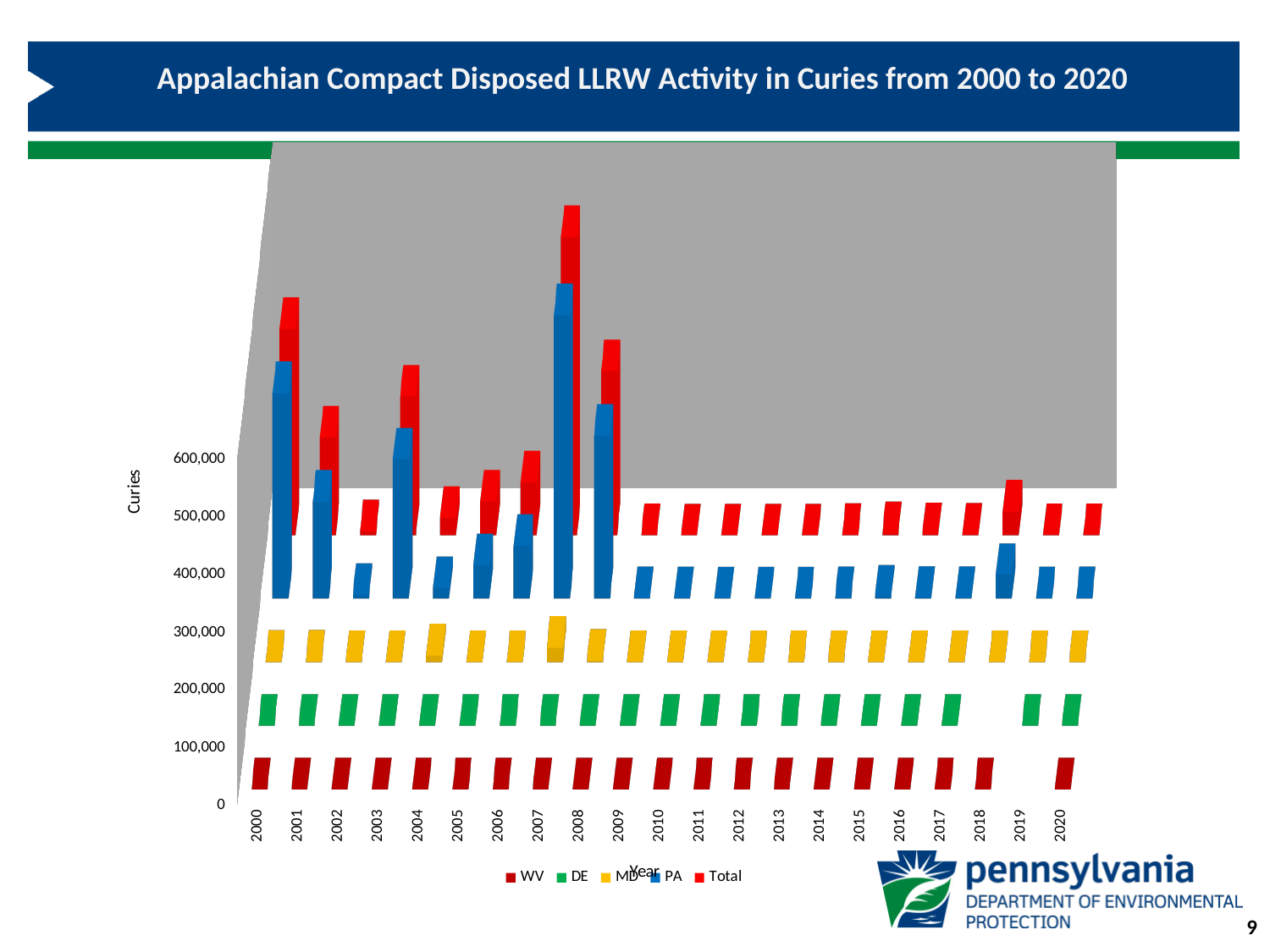
Which year has the larger PA value, 2000 or 2010? 2000 How many series does the legend list? 5 Which year has the larger Total value, 2009 or 2004? 2004 Which year has the larger PA value, 2007 or 2008? 2007 In which year is the Total series highest? 2007 What is the title of the chart? Appalachian Compact Disposed LLRW Activity in Curies from 2000 to 2020 In which year is the PA series highest? 2007 How many years are shown along the x axis? 21 What kind of chart is shown on the slide? Bar chart What are the series names listed in the legend, in order? WV, DE, MD, PA, Total